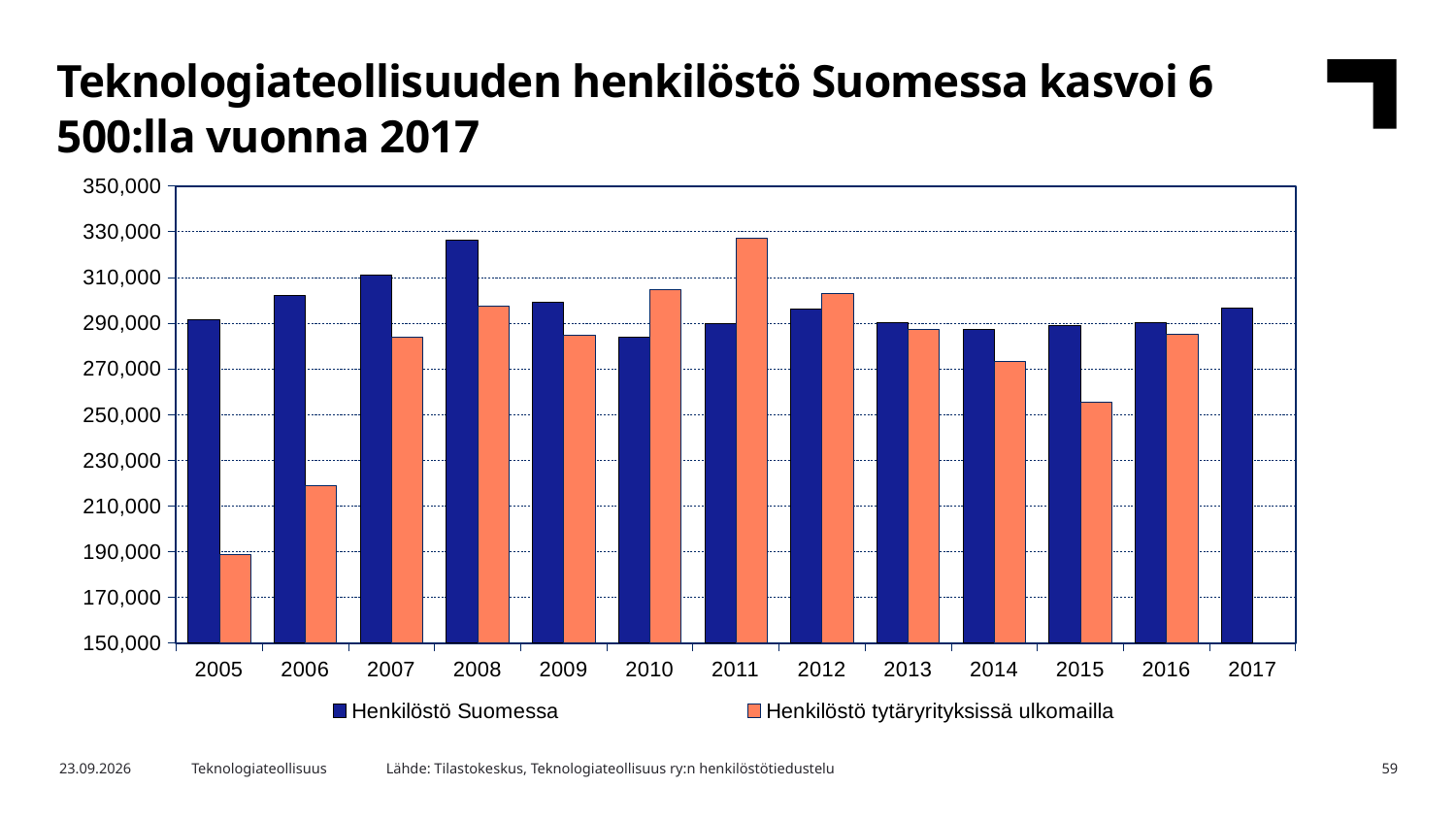
Is the value for Henkilöstö Suomessa in 2008 greater or less than 310,000? greater What kind of chart is shown on the slide? Bar chart In which year is the value for Henkilöstö tytäryrityksissä ulkomailla highest? 2011 In which year is the value for Henkilöstö Suomessa highest? 2008 Is the value for Henkilöstö tytäryrityksissä ulkomailla in 2006 greater or less than 210,000? greater How many years are shown on the x axis? 13 Does the value for Henkilöstö tytäryrityksissä ulkomailla rise or fall from 2005 to 2008? rise In 2011, which series has the larger value: Henkilöstö Suomessa or Henkilöstö tytäryrityksissä ulkomailla? Henkilöstö tytäryrityksissä ulkomailla How many series does the legend list? 2 Is the value for Henkilöstö tytäryrityksissä ulkomailla in 2014 greater or less than 290,000? less In which year is the value for Henkilöstö tytäryrityksissä ulkomailla lowest? 2005 In 2015, which series has the larger value: Henkilöstö Suomessa or Henkilöstö tytäryrityksissä ulkomailla? Henkilöstö Suomessa